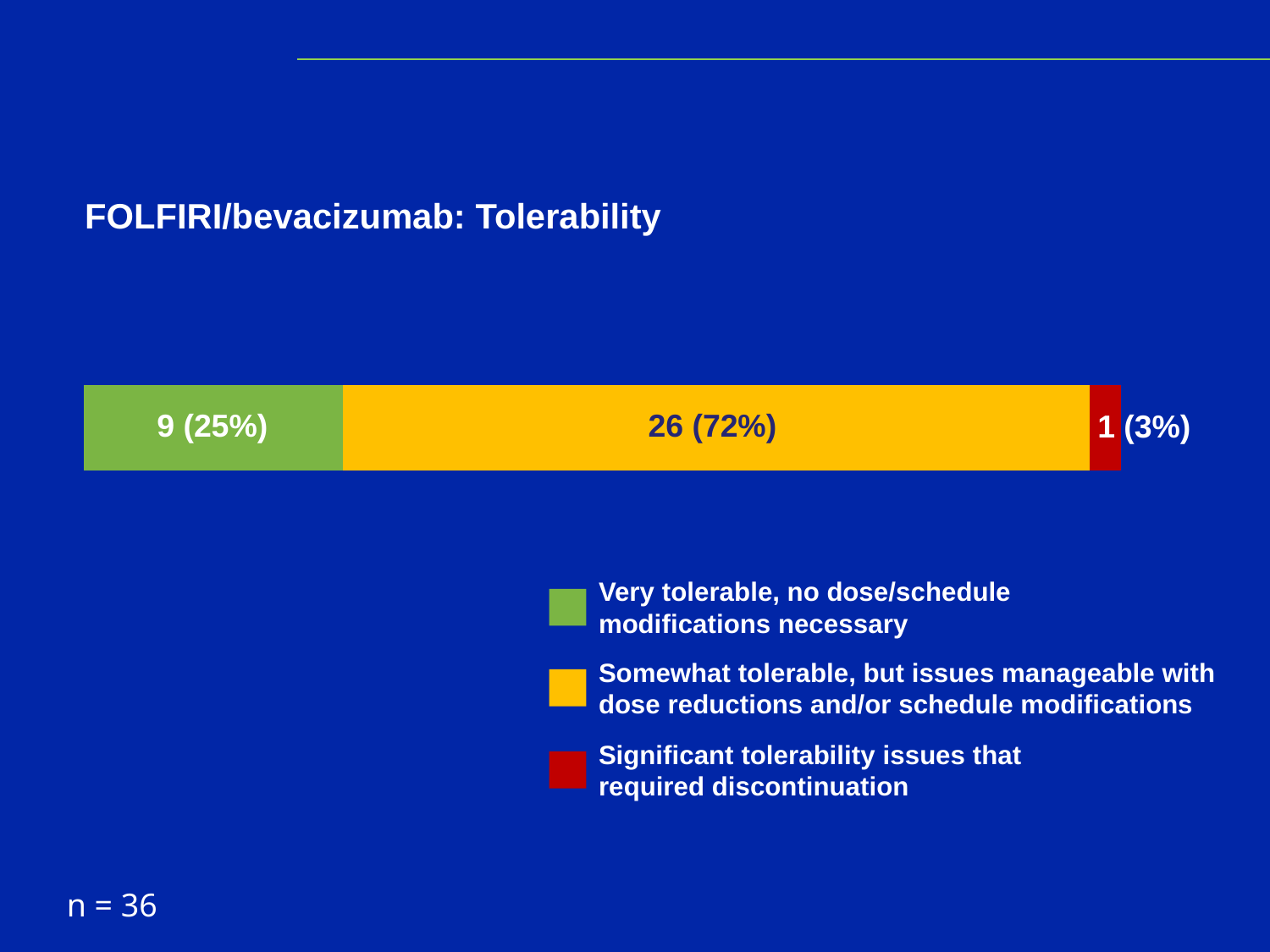
Which category has more respondents: 'very tolerable' or 'significant tolerability issues that required discontinuation'? Very tolerable, no dose/schedule modifications necessary How many entries does the legend list? 3 How many tolerability categories are shown in the bar? 3 What colour represents 'Significant tolerability issues that required discontinuation'? Red Which tolerability category has the smallest number of respondents? Significant tolerability issues that required discontinuation Which tolerability category has the largest number of respondents? Somewhat tolerable, but issues manageable with dose reductions and/or schedule modifications How many respondents rated FOLFIRI/bevacizumab as very tolerable with no dose/schedule modifications necessary? 9 (25%) What is the total number of respondents across all segments of the bar? 36 What is the difference in respondent count between the 'somewhat tolerable' and 'very tolerable' categories? 17 What kind of chart is shown on the slide? Stacked bar chart How many respondents reported significant tolerability issues that required discontinuation? 1 (3%) How many respondents rated FOLFIRI/bevacizumab as somewhat tolerable, with issues manageable by dose reductions and/or schedule modifications? 26 (72%)